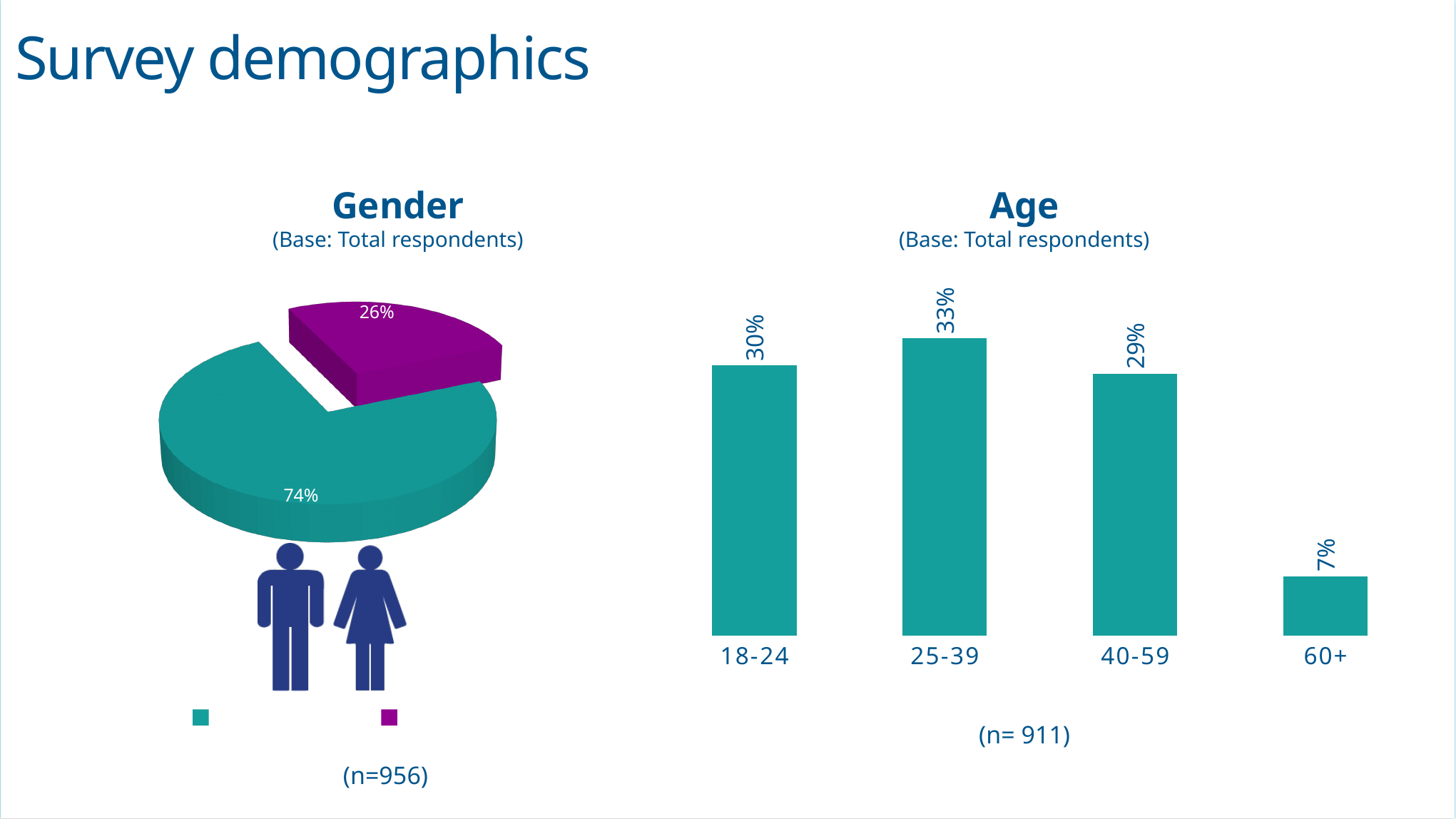
In the Gender pie chart, what share does the teal slice represent? 74% In the Age chart, what is the value for the 60+ age group? 7% In the Age chart, what is the value for the 25-39 age group? 33% In the Age chart, what is the value for the 18-24 age group? 30% What kind of chart is the Age chart? bar chart In the Gender pie chart, what share does the purple slice represent? 26% In the Age chart, which age group has the highest value? 25-39 In the Age chart, what is the difference between the values for 25-39 and 60+? 26% What kind of chart is the Gender chart? pie chart In the Age chart, which is larger, the value for 18-24 or the value for 40-59? 18-24 In the Age chart, which age group has the lowest value? 60+ How many age groups are shown in the Age chart? 4